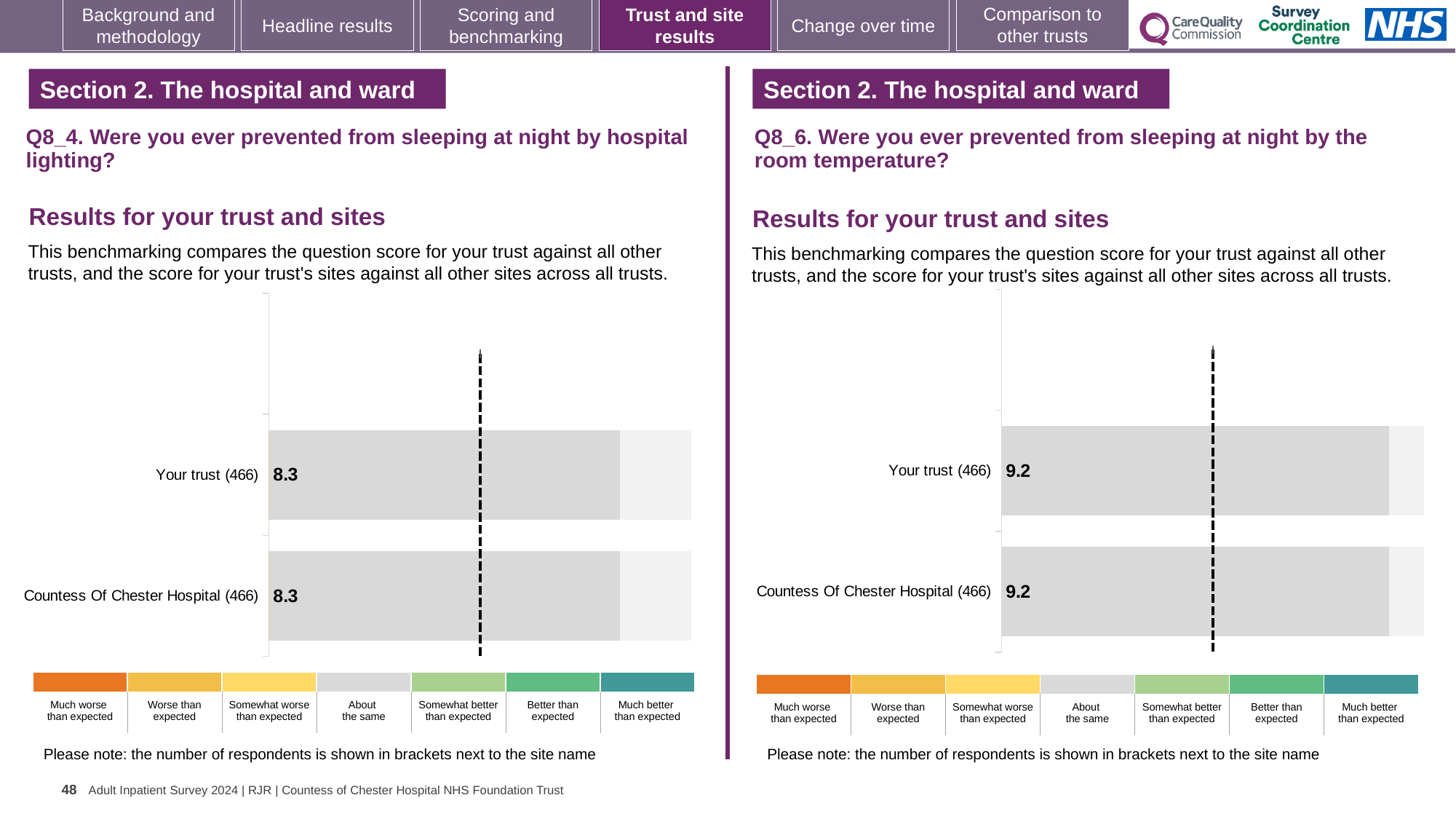
Is the Your trust score in the Q8_6 chart (room temperature) larger than the Your trust score in the Q8_4 chart (hospital lighting)? Yes What type of chart is used for the Q8_4 results (hospital lighting)? Bar chart In the Q8_6 chart (room temperature), how many respondents are shown in brackets for Countess Of Chester Hospital? 466 In the Q8_4 chart (hospital lighting), what is the score for Your trust? 8.3 In the Q8_6 chart (room temperature), what is the difference between the Your trust score and the Countess Of Chester Hospital score? 0 In the Q8_4 chart (hospital lighting), how many respondents are shown in brackets for Your trust? 466 In the Q8_4 chart (hospital lighting), what is the score for Countess Of Chester Hospital? 8.3 How many bars are plotted in the Q8_6 chart (room temperature)? 2 In the Q8_6 chart (room temperature), what is the score for Your trust? 9.2 How many bars are plotted in the Q8_4 chart (hospital lighting)? 2 In the Q8_6 chart (room temperature), what is the score for Countess Of Chester Hospital? 9.2 In the Q8_4 chart (hospital lighting), what is the difference between the Your trust score and the Countess Of Chester Hospital score? 0